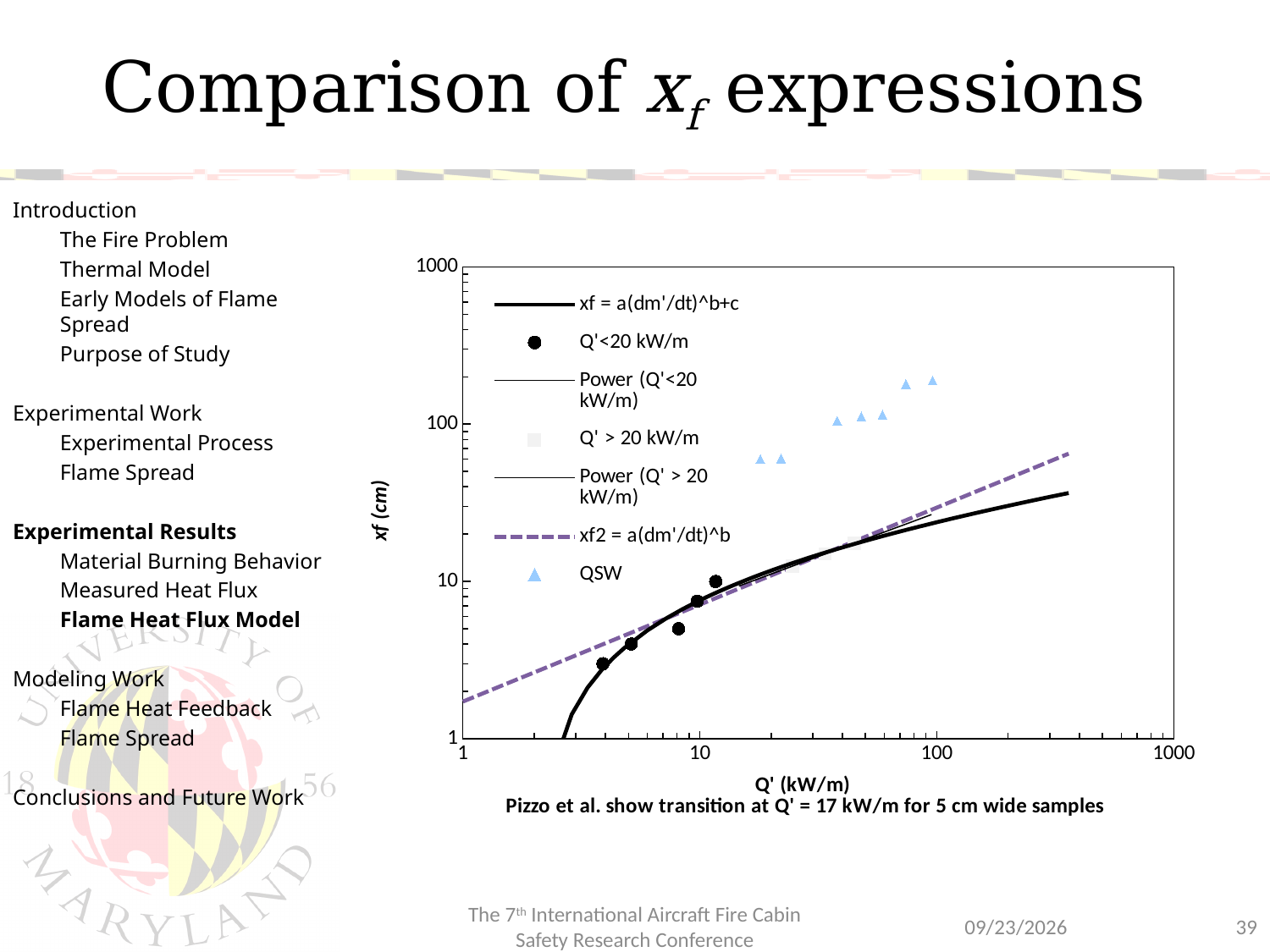
Does the dashed xf2 = a(dm'/dt)^b line rise or fall as Q' increases? rise Are all the Q'<20 kW/m data points below or above 100 cm on the y axis? below Which series has the highest plotted xf values on the chart? QSW What is the largest value shown on the x axis of the chart? 1000 Is the xf value of the highest QSW data point greater or less than 100 cm? greater At the right end of the plotted lines (around Q' = 300 kW/m), which is higher: the dashed xf2 line or the solid xf line? the dashed xf2 line How many entries does the chart legend list? 7 What kind of chart is shown on the slide? scatter chart with fitted lines (log-log axes) What is the label of the y axis of the chart? xf (cm) Do the QSW data points rise or fall as Q' increases? rise What is the label of the x axis of the chart? Q' (kW/m) Is the xf value of the lowest QSW data point greater or less than 10 cm? greater